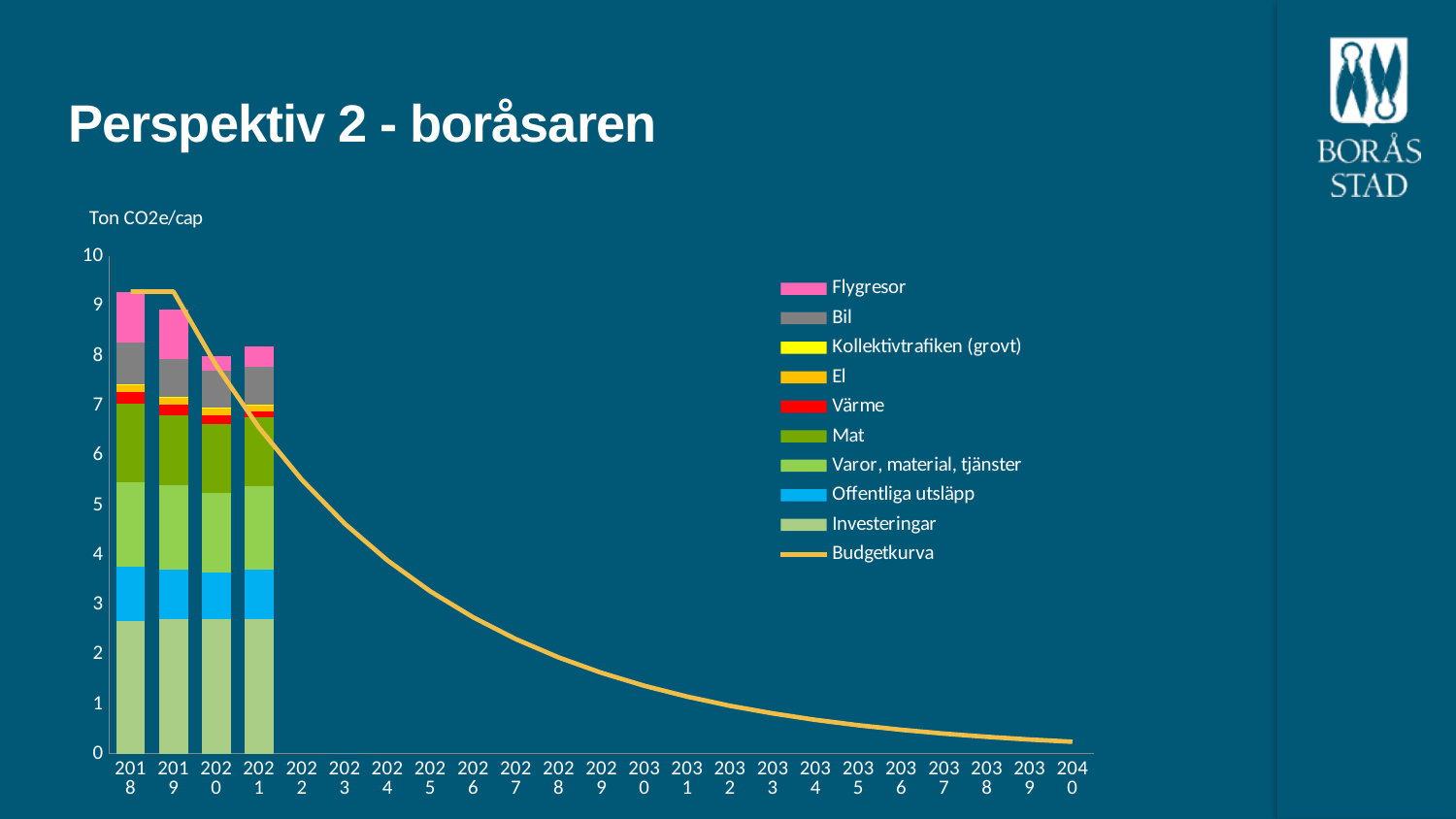
Which legend entry is represented by a line rather than a bar colour? Budgetkurva Is the total of the stacked bar for 2020 greater or less than 9? less What kind of chart is shown on the slide? Stacked bar chart with a line Which stacked bar is taller, 2019 or 2021? 2019 Is the Budgetkurva value in 2040 greater or less than 1? less Does the Budgetkurva line rise or fall from 2019 to 2040? Fall How many entries does the legend list? 10 Which year has the tallest stacked bar? 2018 Is the total of the stacked bar for 2018 greater or less than 8? greater What unit is shown on the y axis of the chart? Ton CO2e/cap How many years have stacked bars plotted? 4 Which year has the shortest stacked bar? 2020